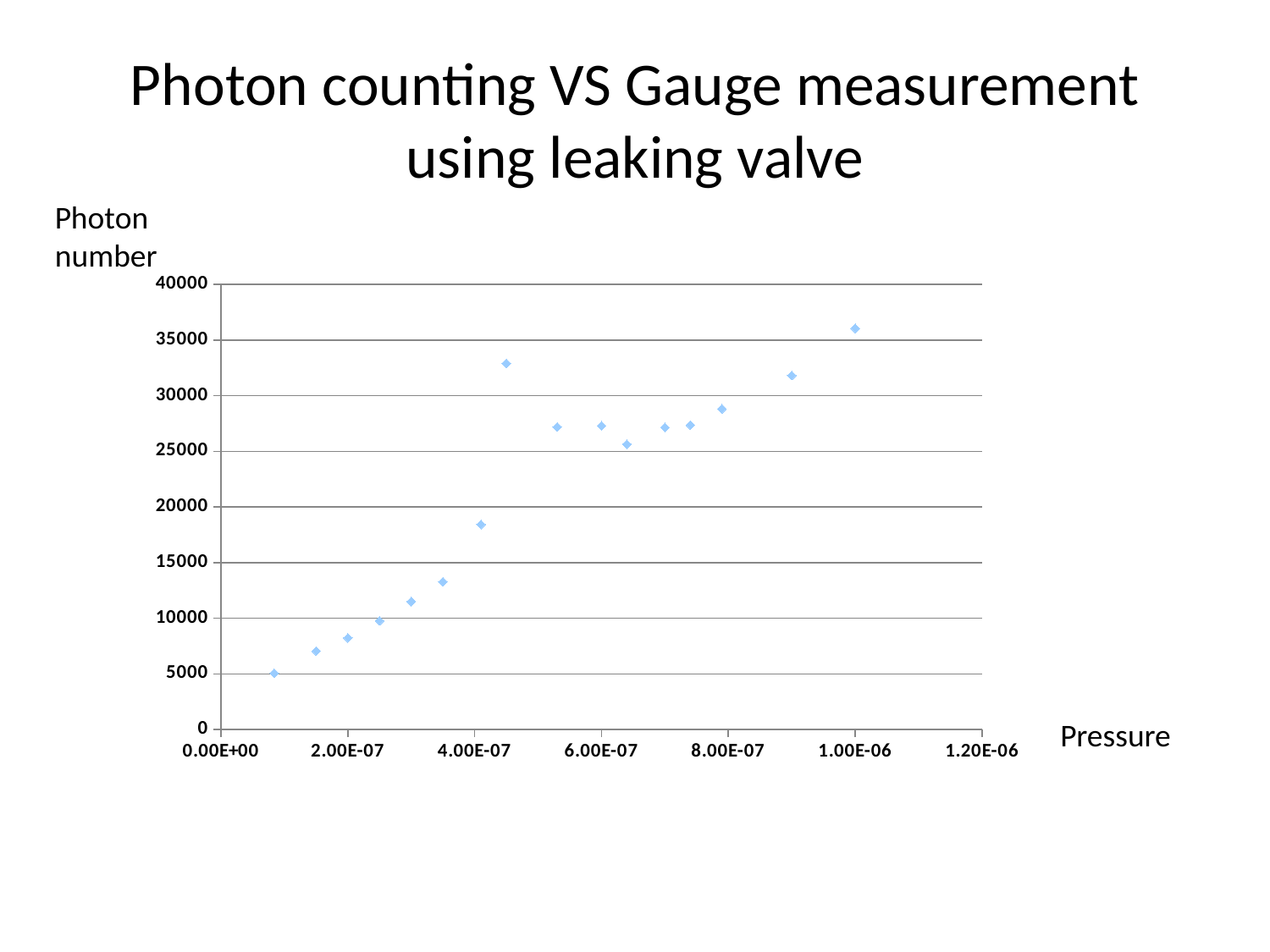
Near which x-axis pressure value does the point with the highest photon number lie? 1.00E-06 What quantity is plotted on the vertical axis? Photon number What is the title of the chart? Photon counting VS Gauge measurement using leaking valve Is the lowest photon number plotted greater or less than 10000? less Is the photon number for the point nearest 6.00E-07 pressure greater or less than 25000? greater What kind of chart is shown on the slide? scatter chart Is the photon number for the point at a pressure of 1.00E-06 greater or less than 35000? greater What is the maximum value shown on the vertical axis? 40000 Overall, do the photon number values rise or fall as pressure increases along the x axis? rise Which has the larger photon number: the point at 1.00E-06 pressure or the point nearest 8.00E-07 pressure? the point at 1.00E-06